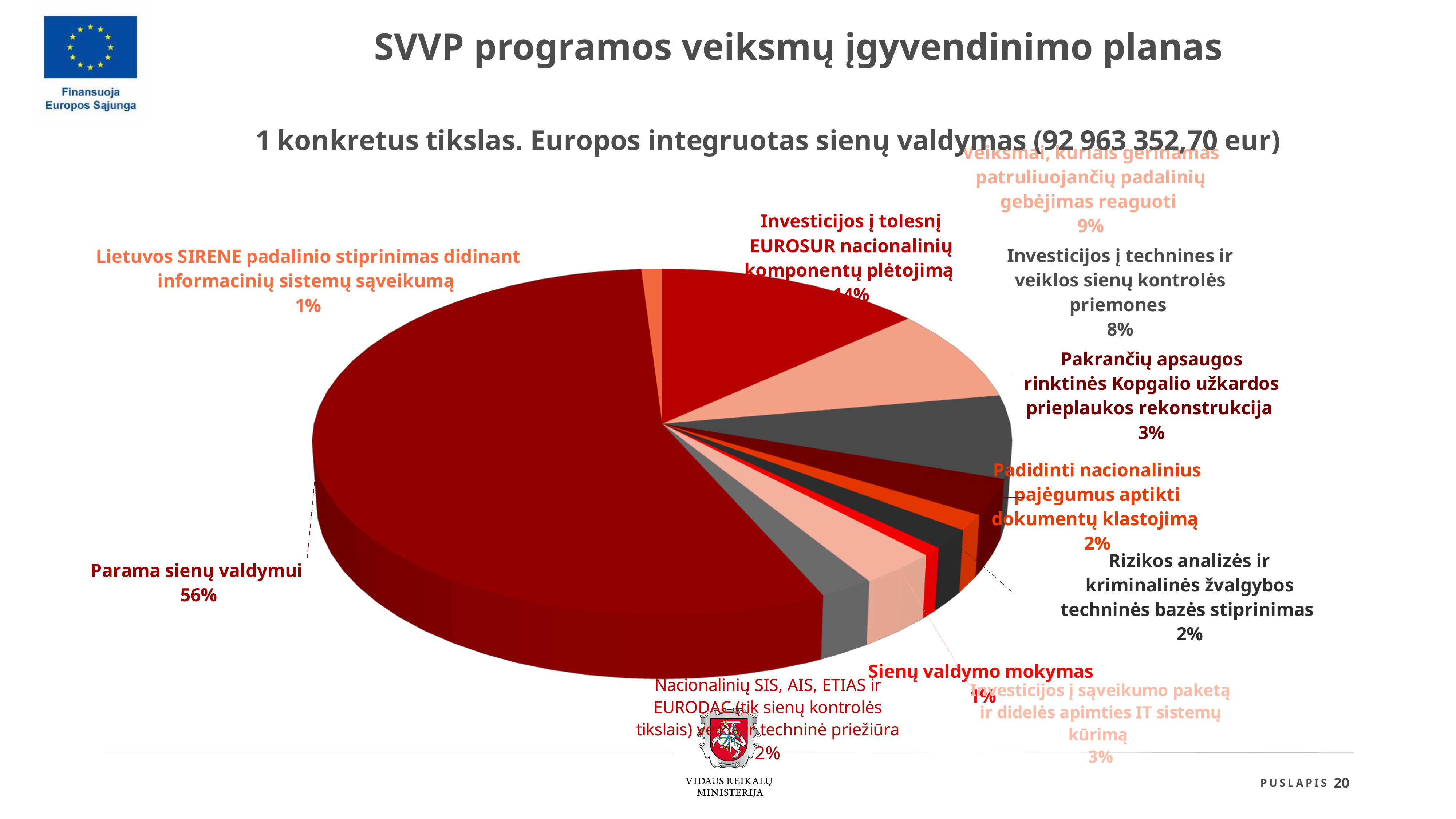
What total amount in euros is given in the chart title? 92 963 352,70 eur How many categories (slices) are labelled in the pie chart? 11 What kind of chart is shown on the slide? pie chart Which is larger: the share for "Investicijos į technines ir veiklos sienų kontrolės priemones" or for "Investicijos į sąveikumo paketą ir didelės apimties IT sistemų kūrimą"? Investicijos į technines ir veiklos sienų kontrolės priemones What share of the pie does "Parama sienų valdymui" have? 56% What share is shown for "Rizikos analizės ir kriminalinės žvalgybos techninės bazės stiprinimas"? 2% What share is shown for "Sienų valdymo mokymas"? 1% What share is shown for "Investicijos į technines ir veiklos sienų kontrolės priemones"? 8% What share is shown for "Veiksmai, kuriais gerinamas patruliuojančių padalinių gebėjimas reaguoti"? 9% Which category has the largest share of the pie? Parama sienų valdymui What share is shown for "Pakrančių apsaugos rinktinės Kopgalio užkardos prieplaukos rekonstrukcija"? 3% What is the difference in percentage points between "Parama sienų valdymui" and "Investicijos į technines ir veiklos sienų kontrolės priemones"? 48